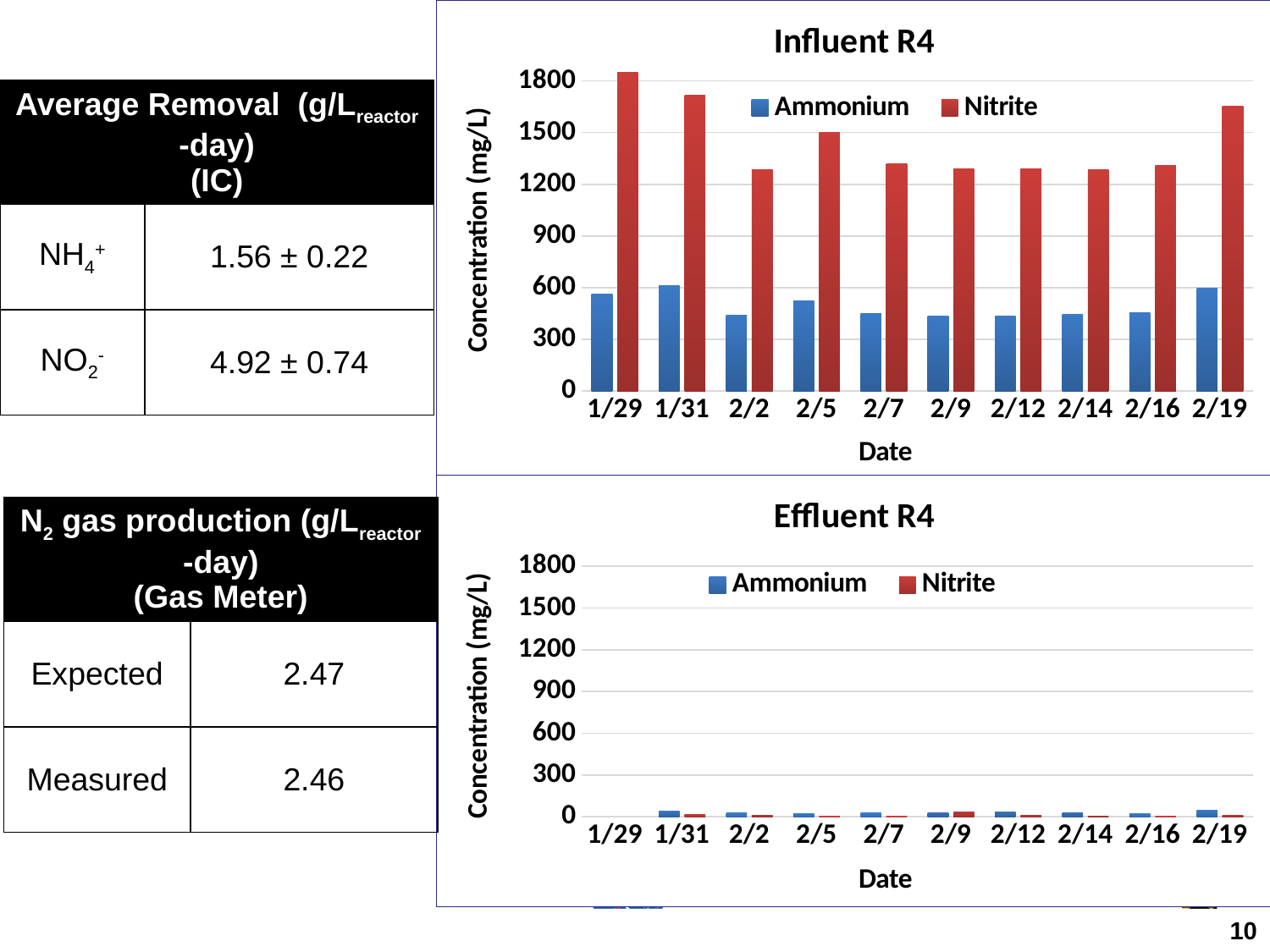
How many series does the legend of the Influent R4 chart list? 2 How many dates are shown on the x axis of the Effluent R4 chart? 10 In the Influent R4 chart, is the Ammonium value for 2/2 greater or less than 600? less In the Influent R4 chart, on which date is the Nitrite concentration highest? 1/29 What is the y-axis label of the Effluent R4 chart? Concentration (mg/L) What kind of chart is the Influent R4 chart? bar chart In the Influent R4 chart, which is larger on 1/29: Ammonium or Nitrite? Nitrite In the Influent R4 chart, is the Nitrite value for 1/31 greater or less than 1500? greater In the Effluent R4 chart, is the Ammonium value for 2/19 greater or less than 300? less In the Influent R4 chart, which colour represents Nitrite? red